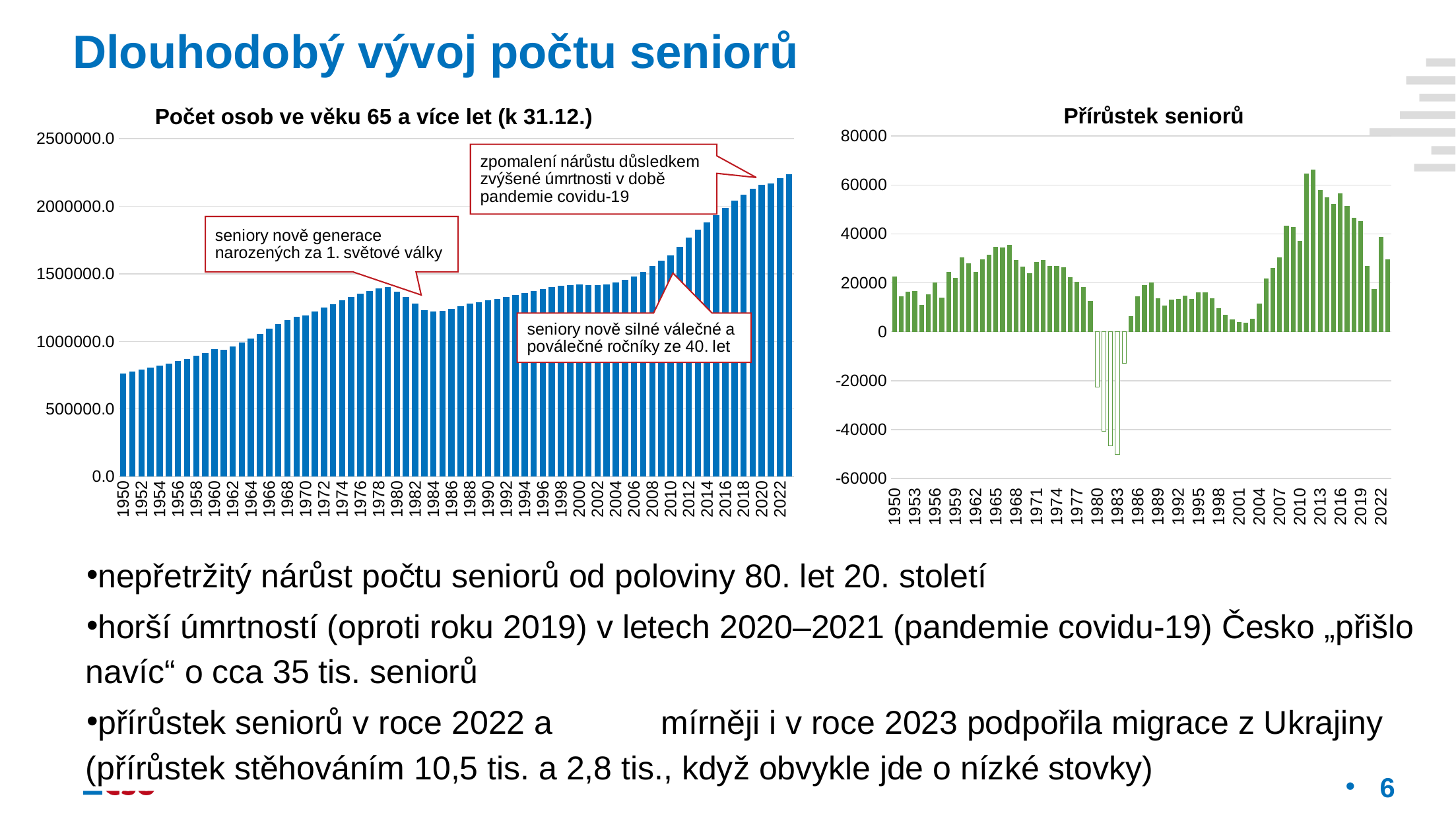
In the chart "Počet osob ve věku 65 a více let (k 31.12.)", do the values generally rise or fall from 1950 to 2023? rise In the chart "Počet osob ve věku 65 a více let (k 31.12.)", which year has the lowest value? 1950 What kind of chart is "Počet osob ve věku 65 a více let (k 31.12.)"? bar chart What is the title of the chart on the right side of the slide? Přírůstek seniorů In the chart "Počet osob ve věku 65 a více let (k 31.12.)", is the value for 2023 greater or less than 2000000? greater In the chart "Přírůstek seniorů", is the value for 2001 greater or less than 20000? less In the chart "Přírůstek seniorů", which year has the highest value? 2012 In the chart "Počet osob ve věku 65 a více let (k 31.12.)", which year has the highest value? 2023 In the chart "Počet osob ve věku 65 a více let (k 31.12.)", which is larger, the value for 1990 or the value for 2010? 2010 In the chart "Počet osob ve věku 65 a více let (k 31.12.)", is the value for 1950 greater or less than 1000000? less In the chart "Přírůstek seniorů", which year has the lowest value? 1983